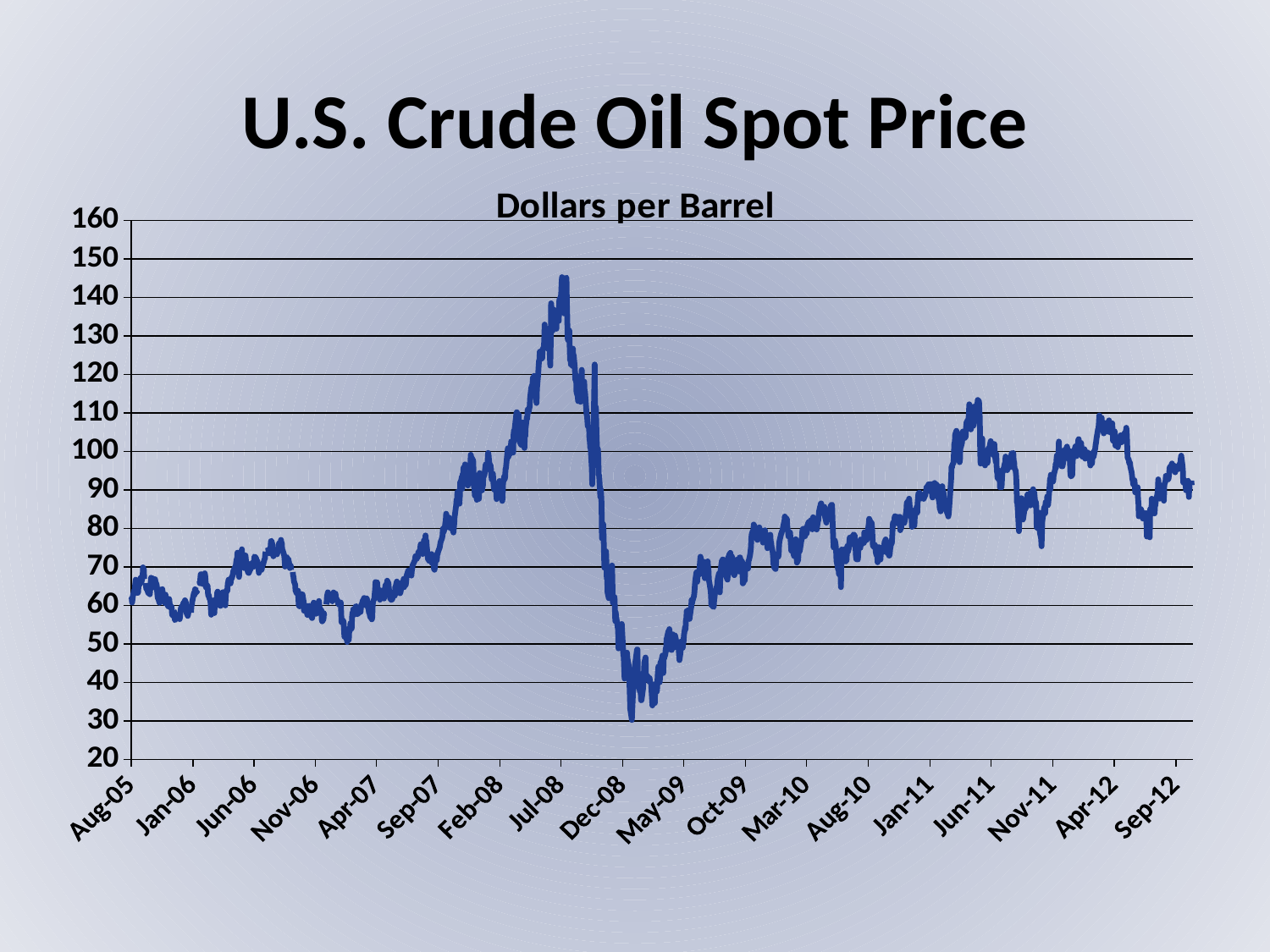
Is the lowest value of the line, shortly after Dec-08, greater or less than 40? less Is the peak value around Jul-08 greater or less than 130? greater How many month labels are shown on the x axis? 18 Does the line rise or fall between Jul-08 and Dec-08? fall Which is larger, the value around Jul-08 or the value around Dec-08? Jul-08 What is the title of the chart? U.S. Crude Oil Spot Price Is the value at Sep-12 greater or less than 80? greater What unit is the price measured in, according to the chart subtitle? Dollars per Barrel Is the lowest point of the line closer to the Dec-08 label or the May-09 label? Dec-08 Around which labeled month does the line reach its highest point? Jul-08 What kind of chart is shown on the slide? line chart